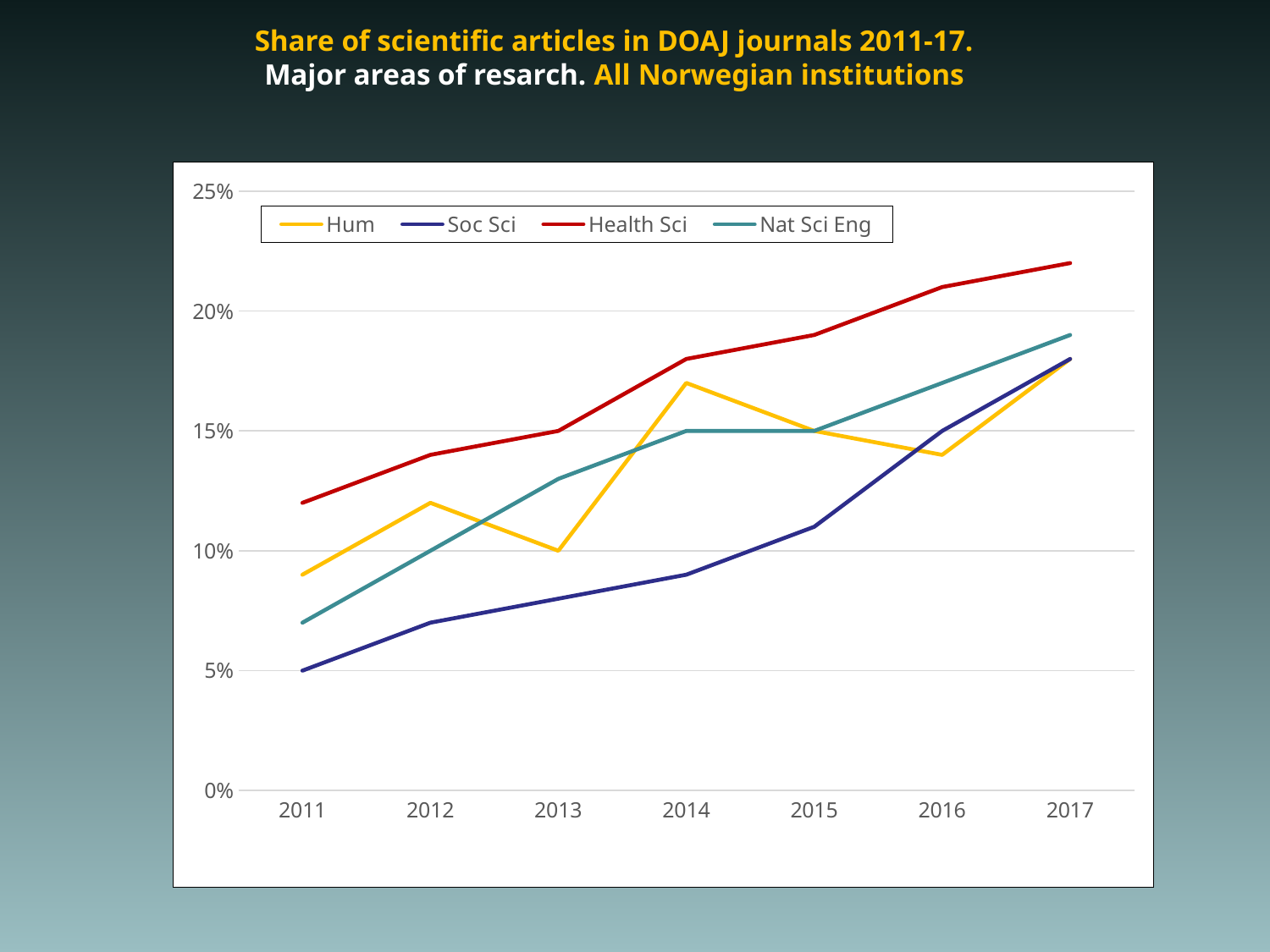
How many years are shown on the x axis? 7 Which series has the highest value in 2017? Health Sci Does the Health Sci line rise or fall from 2011 to 2017? rise Is the value for Soc Sci in 2014 greater or less than 10%? less Which is larger in 2012, Health Sci or Soc Sci? Health Sci How many series does the legend list? 4 What is the value for Soc Sci in 2011? 5% What kind of chart is shown on the slide? line chart Is the value for Health Sci in 2017 greater or less than 20%? greater Which series has the lowest value in 2011? Soc Sci What is the value for Health Sci in 2013? 15% Which series is drawn in red? Health Sci